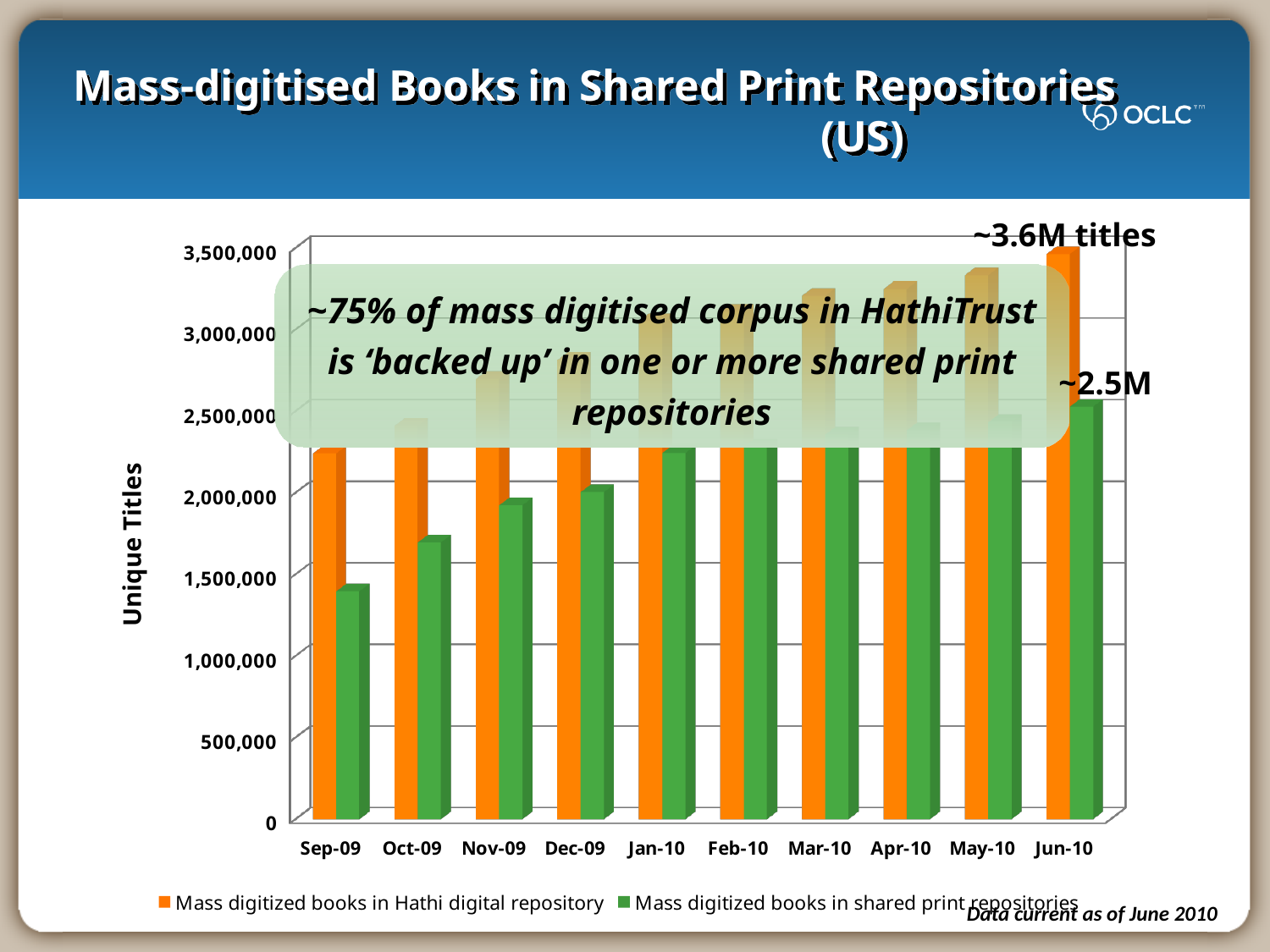
Is the value for mass digitized books in shared print repositories in Sep-09 greater or less than 1,500,000? less Is the value for mass digitized books in Hathi digital repository in Jun-10 greater or less than 3,000,000? greater In which month is the value for mass digitized books in shared print repositories lowest? Sep-09 Is the value for mass digitized books in shared print repositories in Jan-10 greater or less than 2,000,000? greater Do the values for mass digitized books in shared print repositories rise or fall from Sep-09 to Jun-10? rise How many months are shown along the x axis? 10 In which month is the value for mass digitized books in Hathi digital repository highest? Jun-10 In Sep-09, which is larger: mass digitized books in Hathi digital repository or mass digitized books in shared print repositories? Mass digitized books in Hathi digital repository What kind of chart is shown on the slide? bar chart How many series does the legend list? 2 What is the label on the vertical axis of the chart? Unique Titles